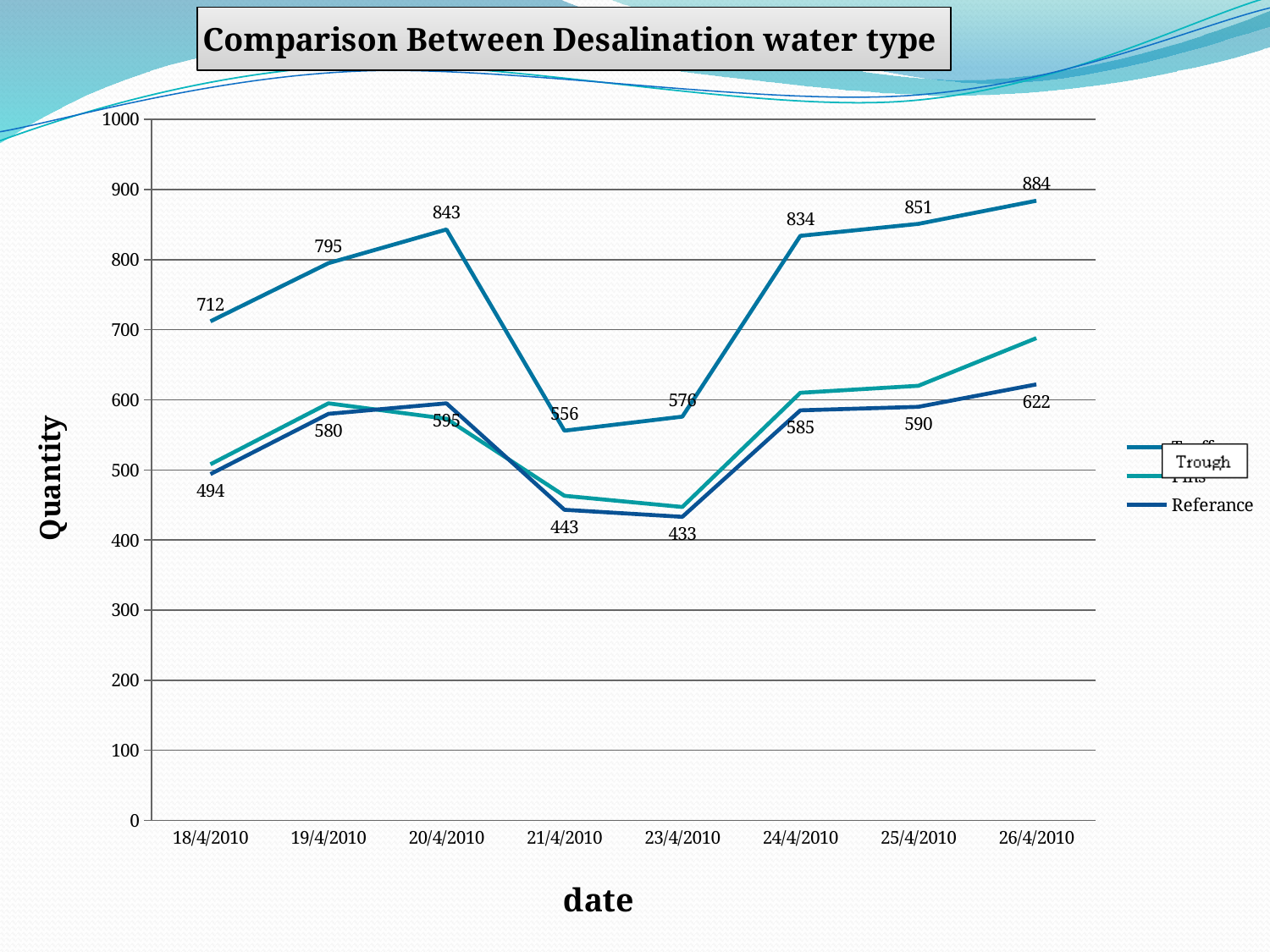
On which date is the Referance series at its highest? 26/4/2010 How many series does the legend list? 3 On which date is the Referance series at its lowest? 23/4/2010 Which date has the larger Referance value, 19/4/2010 or 20/4/2010? 20/4/2010 By how much does the Referance value on 26/4/2010 exceed the Referance value on 18/4/2010? 128 What is the value of the top line (the series with the highest values) on 26/4/2010? 884 How many dates are plotted along the x axis? 8 What is the title of the vertical axis? Quantity What kind of chart is shown on the slide? line chart What is the Referance value on 18/4/2010? 494 What is the Referance value on 26/4/2010? 622 On which date does the top line (the series with the highest values) reach its lowest value? 21/4/2010